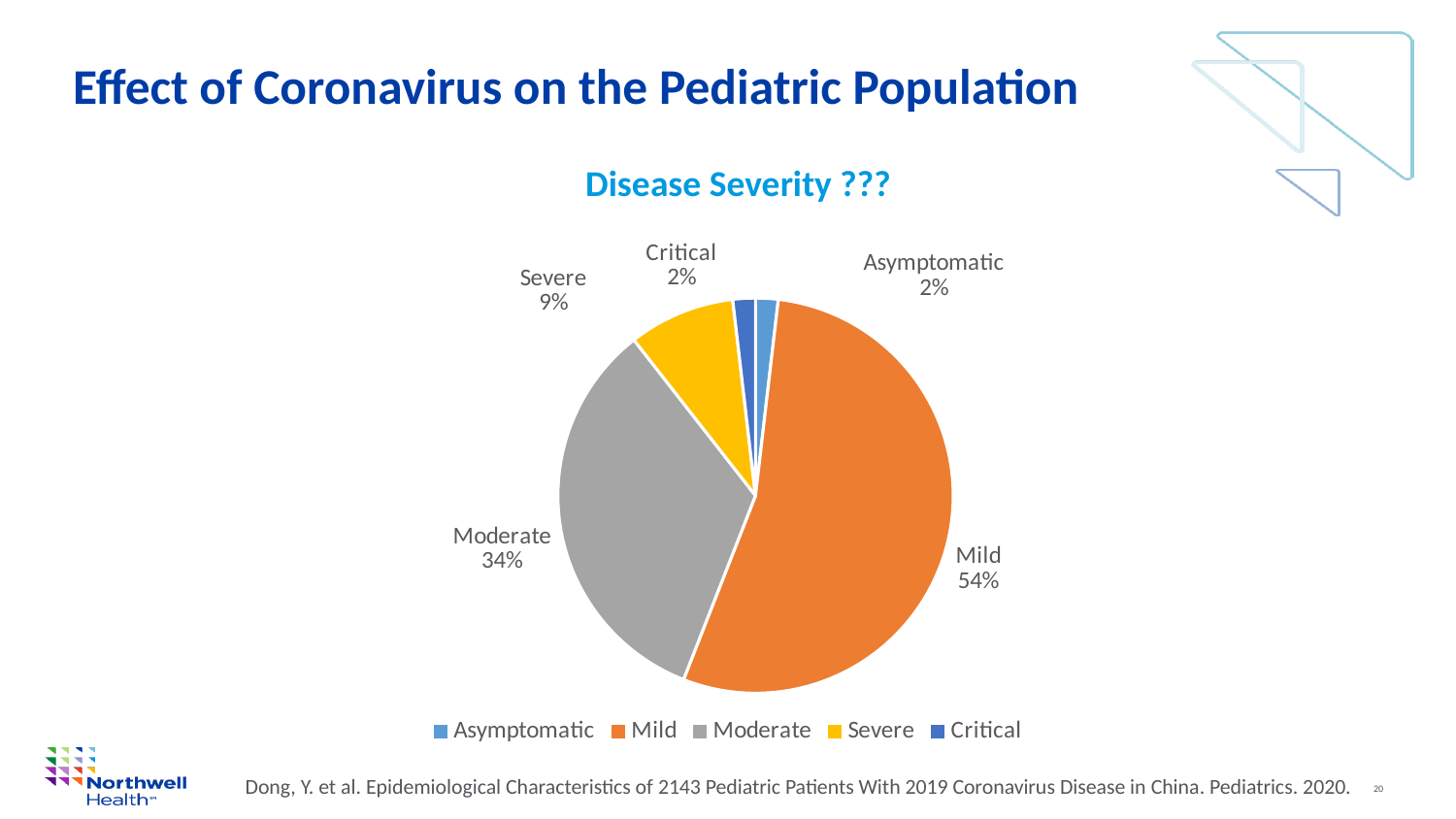
What percentage of the pie is labelled Severe? 9% What colour is the Severe slice? Yellow What is the difference in percentage points between the Mild and Moderate slices? 20 What percentage of the pie is labelled Moderate? 34% What is the title of the chart? Disease Severity ??? How many categories does the pie chart have? 5 How many entries does the legend list? 5 What percentage of the pie is labelled Mild? 54% Which slice is larger, Moderate or Severe? Moderate Which category has the largest share of the pie? Mild What kind of chart is shown on the slide? Pie chart What percentage of the pie is labelled Critical? 2%